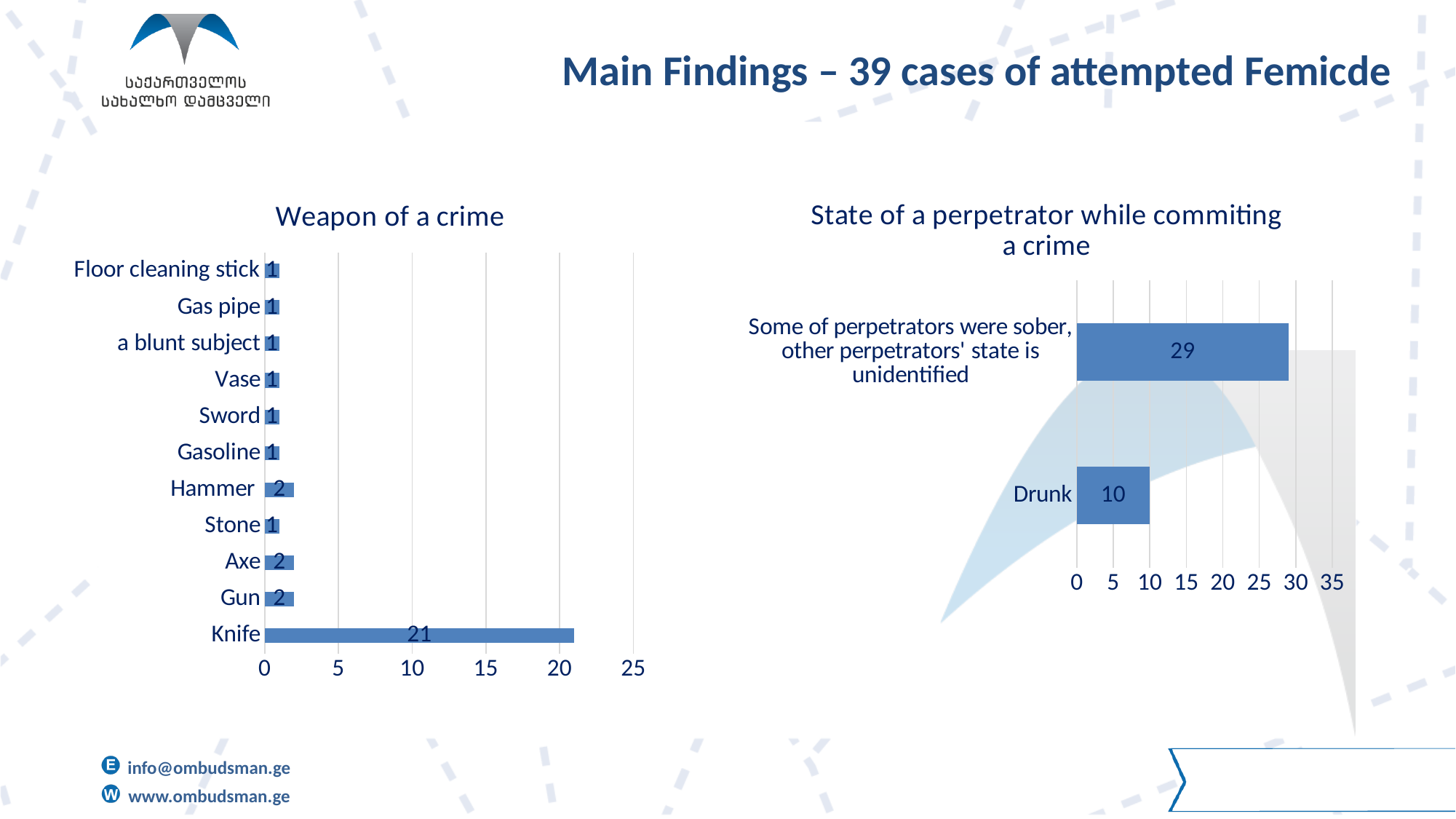
In the 'Weapon of a crime' chart, what is the value for Knife? 21 In the 'State of a perpetrator while commiting a crime' chart, what is the difference between the two bars? 19 In the 'Weapon of a crime' chart, which weapon has the highest value? Knife In the 'Weapon of a crime' chart, what is the difference between the values for Knife and Gun? 19 In the 'Weapon of a crime' chart, is the value for Knife greater or less than 20? greater What kind of chart is the 'Weapon of a crime' chart? Bar chart In the 'Weapon of a crime' chart, which is larger, the value for Axe or the value for Stone? Axe In the 'State of a perpetrator while commiting a crime' chart, what is the value for Drunk? 10 In the 'State of a perpetrator while commiting a crime' chart, how many categories are shown? 2 In the 'State of a perpetrator while commiting a crime' chart, what is the value for 'Some of perpetrators were sober, other perpetrators' state is unidentified'? 29 In the 'Weapon of a crime' chart, what is the value for Hammer? 2 In the 'Weapon of a crime' chart, how many weapon categories are shown? 11